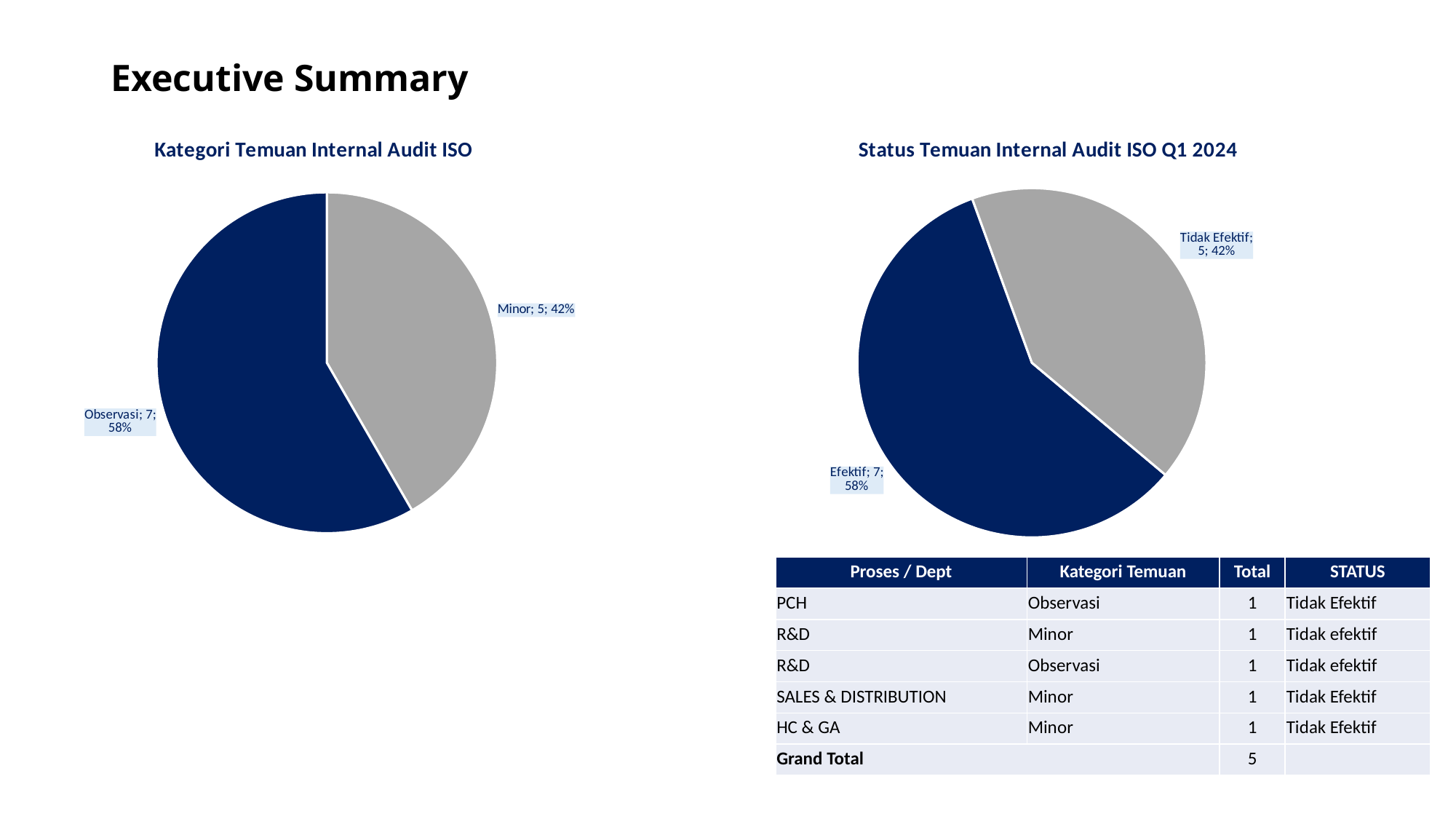
In the 'Kategori Temuan Internal Audit ISO' chart, what is the total number of findings across both slices? 12 In the 'Status Temuan Internal Audit ISO Q1 2024' chart, what is the difference between the Efektif and Tidak Efektif counts? 2 What kind of chart is 'Kategori Temuan Internal Audit ISO'? Pie chart In the 'Status Temuan Internal Audit ISO Q1 2024' chart, what colour is the Efektif slice? Dark blue In the 'Status Temuan Internal Audit ISO Q1 2024' chart, how many findings are Tidak Efektif? 5 In the 'Kategori Temuan Internal Audit ISO' chart, which category has the largest slice? Observasi In the 'Status Temuan Internal Audit ISO Q1 2024' chart, which is larger, Efektif or Tidak Efektif? Efektif In the 'Kategori Temuan Internal Audit ISO' chart, how many findings are in the Observasi category? 7 In the 'Kategori Temuan Internal Audit ISO' chart, what share of the pie is Minor? 42% In the 'Kategori Temuan Internal Audit ISO' chart, how many slices does the pie have? 2 In the 'Status Temuan Internal Audit ISO Q1 2024' chart, which status has the smallest slice? Tidak Efektif In the 'Status Temuan Internal Audit ISO Q1 2024' chart, what share of the pie is Efektif? 58%